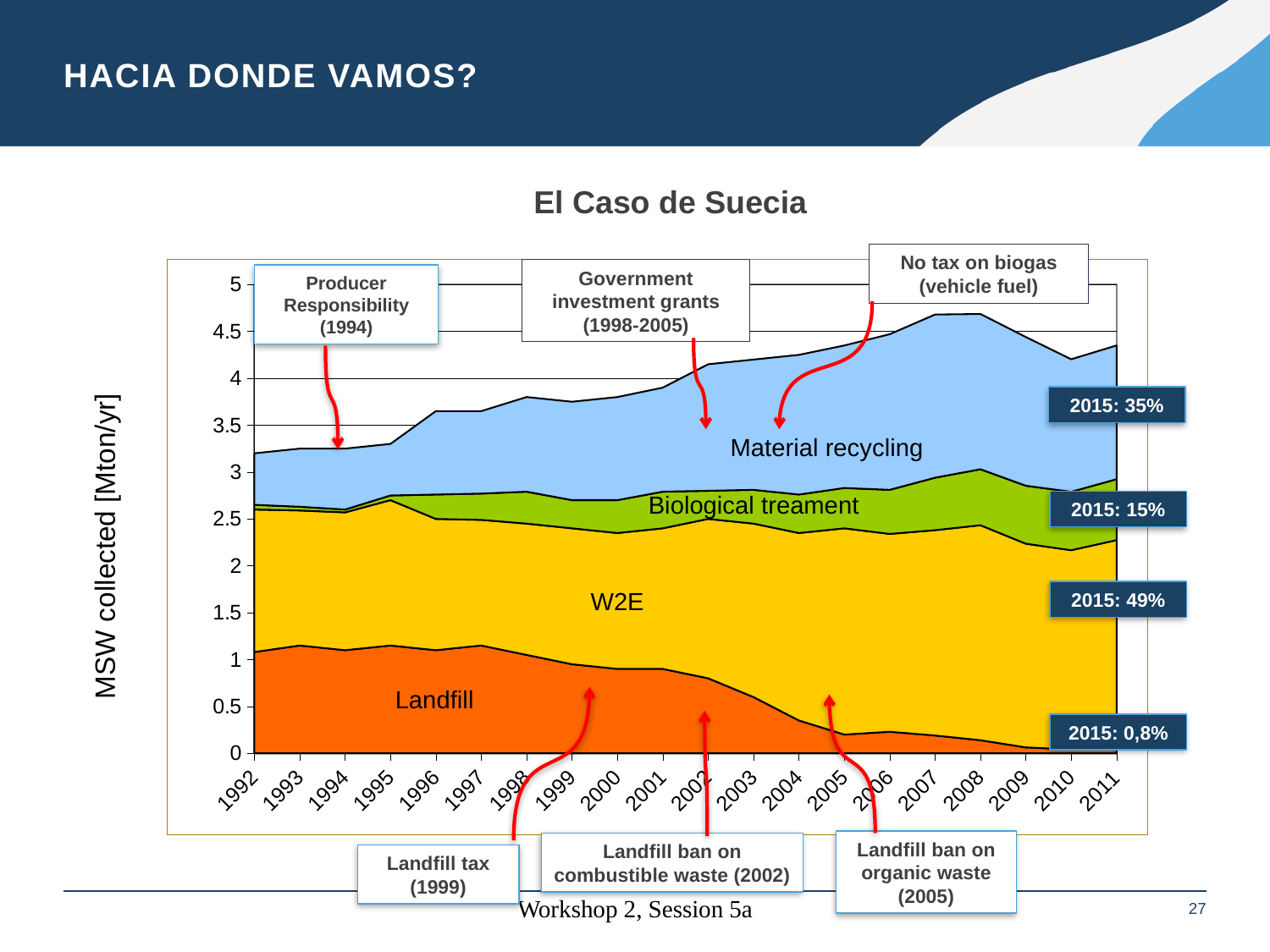
What is the label on the y axis of the chart? MSW collected [Mton/yr] Does the Landfill area rise or fall from 1992 to 2011? Fall How many waste-treatment series are stacked in the chart? 4 Is the Landfill value in 2011 greater or less than 0.5 Mton/yr? less How many years are shown along the x axis of the chart? 20 Which series has the largest share of MSW in 2011? W2E Is the total MSW collected in 2011 greater or less than 4 Mton/yr? greater Is the Landfill value larger in 1992 or in 2011? 1992 Is the total MSW collected in 1992 greater or less than 3 Mton/yr? greater Which series has the smallest share of MSW in 2011? Landfill What kind of chart is shown on the slide? Stacked area chart